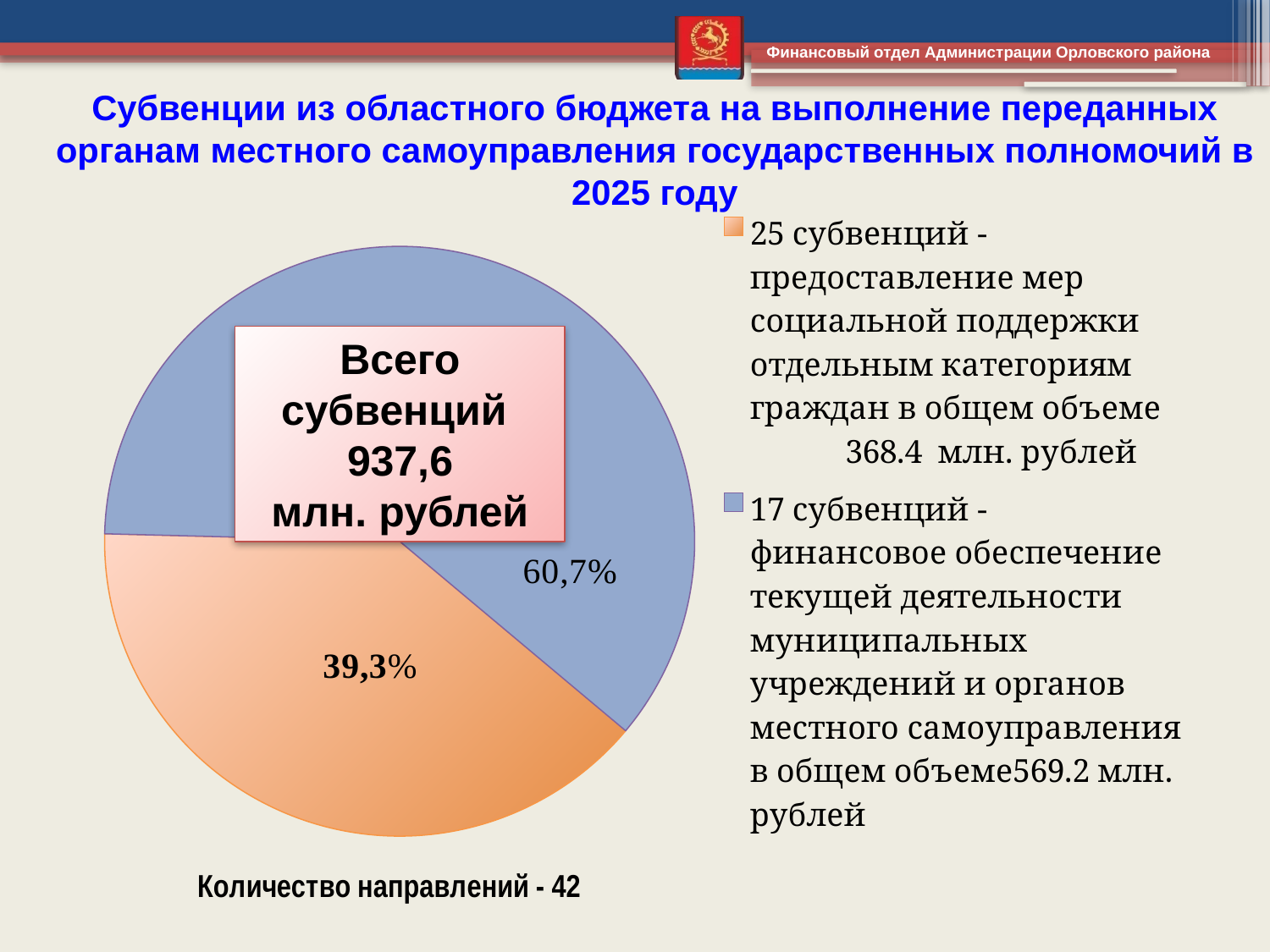
What is the amount in million rubles for the 25 subventions for social support measures? 368.4 млн. рублей What kind of chart is shown on the slide? pie chart What share of the pie is labelled for the orange slice (25 субвенций - предоставление мер социальной поддержки)? 39,3% What is the amount in million rubles for the 17 subventions for financial support of municipal institutions? 569.2 млн. рублей What is the difference in percentage points between the blue slice (60,7%) and the orange slice (39,3%)? 21,4 What total amount of subventions is shown in the box in the centre of the pie chart? 937,6 млн. рублей Which is larger: the share for social support subventions or the share for financial support of municipal institutions? financial support of municipal institutions (60,7%) How many slices does the pie chart have? 2 Which slice of the pie is the largest? 17 субвенций - финансовое обеспечение текущей деятельности (blue, 60,7%) What number of directions (Количество направлений) is stated below the pie chart? 42 What share of the pie is labelled for the blue slice (17 субвенций - финансовое обеспечение текущей деятельности)? 60,7% Which slice of the pie is the smallest? 25 субвенций - предоставление мер социальной поддержки (orange, 39,3%)